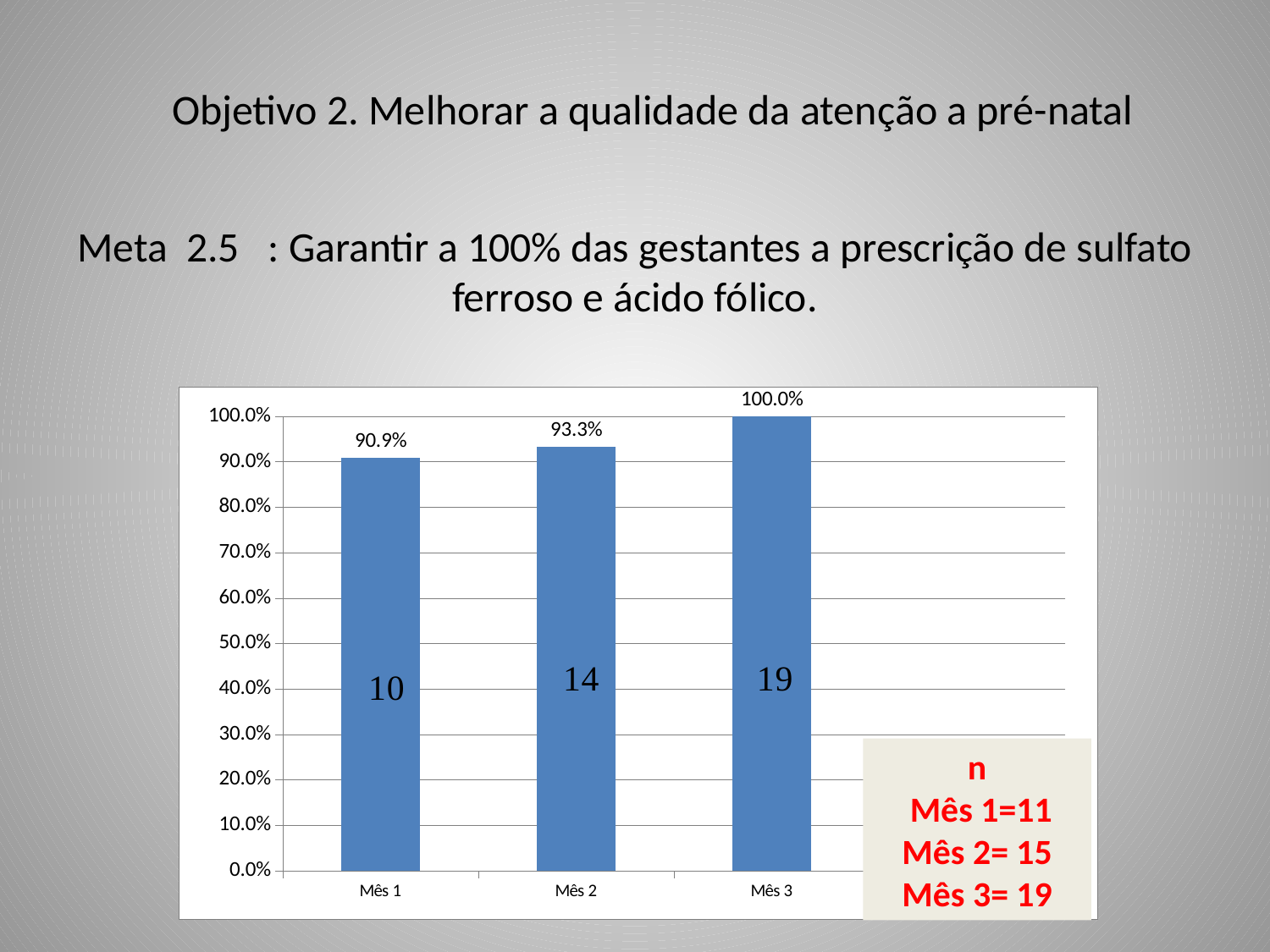
What is the percentage value shown for Mês 1? 90.9% Is the value for Mês 1 greater or less than 80.0%? greater Which is larger, the percentage for Mês 1 or for Mês 2? Mês 2 What is the difference in percentage points between Mês 3 and Mês 1? 9.1 What is the percentage value shown for Mês 2? 93.3% Do the percentages rise or fall from Mês 1 to Mês 3? rise What is the percentage value shown for Mês 3? 100.0% Which month has the lowest percentage? Mês 1 How many months (categories) are shown on the x axis? 3 What number is printed inside the bar for Mês 2? 14 What kind of chart is shown on the slide? bar chart Which month has the highest percentage? Mês 3